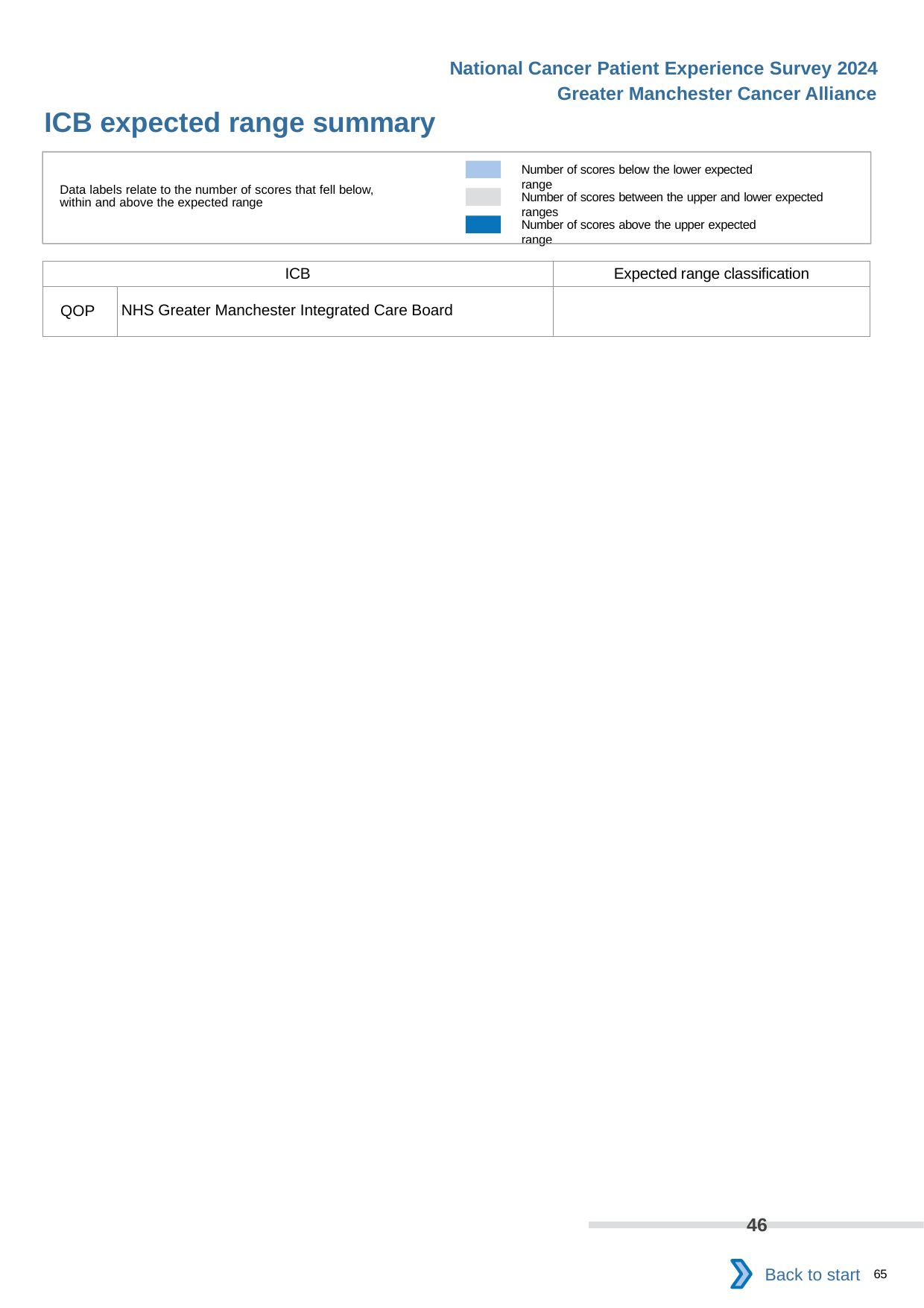
What value is printed as the data label on the bar at the bottom of the slide? 46 According to the key, what does the grey colour represent? Number of scores between the upper and lower expected ranges What kind of chart is shown at the bottom of the slide? bar chart According to the key, what does the dark blue colour represent? Number of scores above the upper expected range How many categories does the key above the table list for the expected range classification? 3